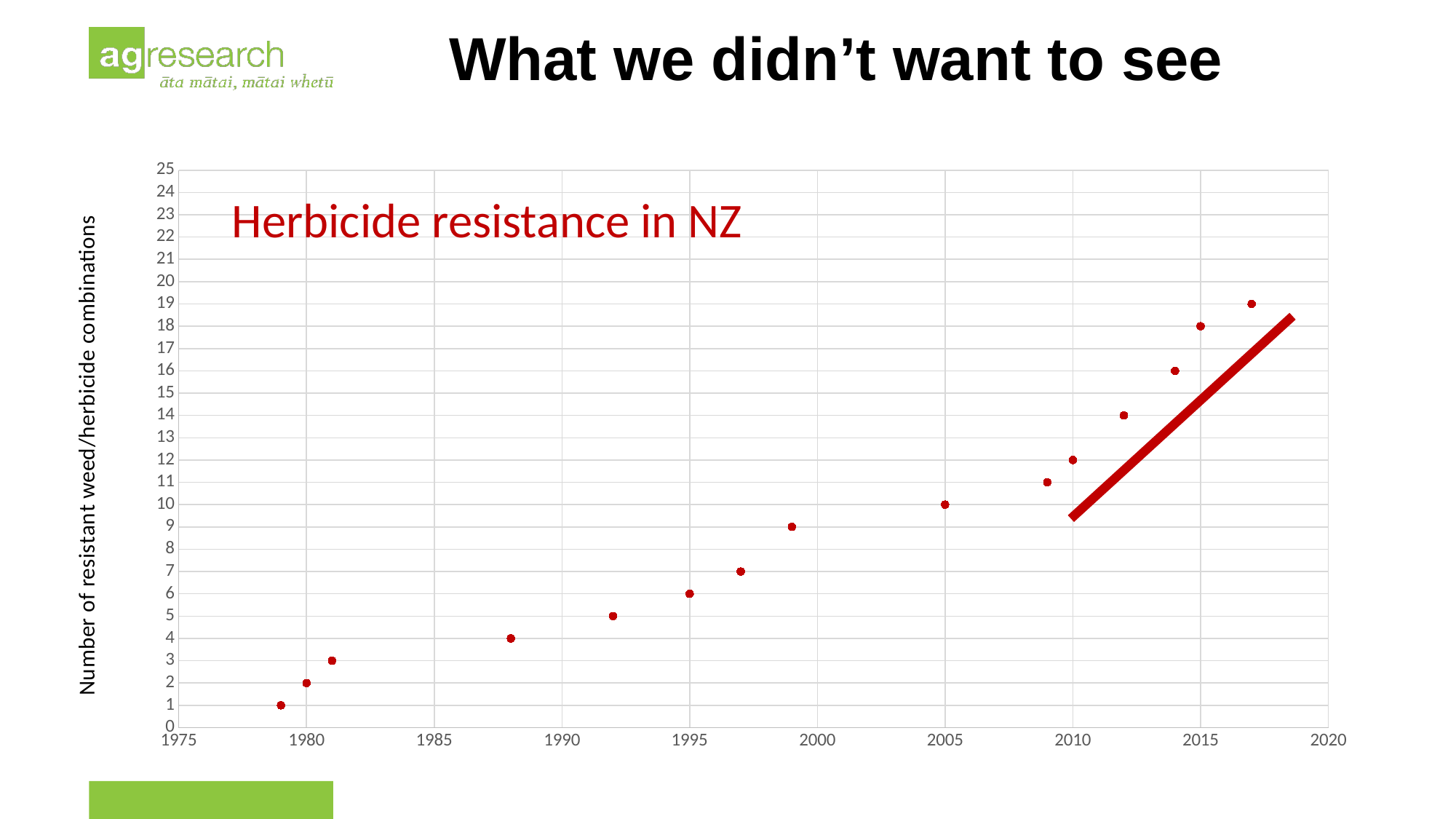
What is the number of resistant weed/herbicide combinations plotted for 2015? 18 What is the number of resistant weed/herbicide combinations plotted for 1980? 2 What is the title of the chart? Herbicide resistance in NZ What is the highest value plotted on the chart? 19 What is the number of resistant weed/herbicide combinations plotted for 1995? 6 What kind of chart is shown on the slide? Scatter chart What is the number of resistant weed/herbicide combinations plotted for 2005? 10 Do the plotted values rise or fall as the years increase along the x axis? Rise What is the difference between the values plotted for 2015 and 2005? 8 What is the label of the y axis? Number of resistant weed/herbicide combinations What is the number of resistant weed/herbicide combinations plotted for 2010? 12 Which year has the larger plotted value, 1995 or 2010? 2010